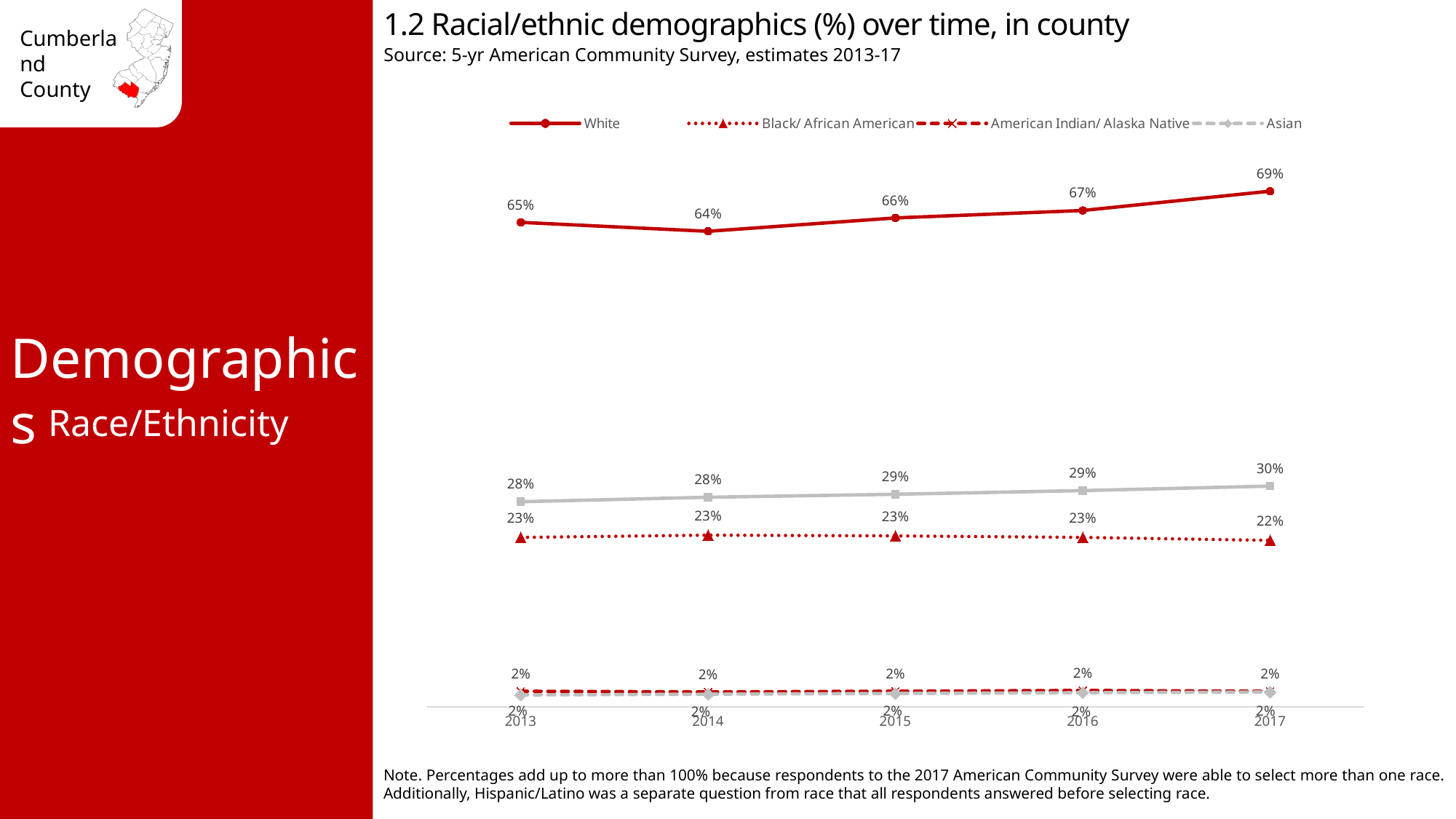
What is the value for White in 2017? 69% What is the value for Black/ African American in 2015? 23% In which year is the White percentage highest? 2017 What is the value for Black/ African American in 2017? 22% What kind of chart is shown on the slide? line chart Which is larger in 2013, the White value or the Black/ African American value? White Does the White percentage rise or fall from 2014 to 2017? rise What is the difference between the White value in 2017 and in 2013? 4 percentage points How many series does the legend list? 4 How many years are shown on the x axis? 5 In which year is the White percentage lowest? 2014 What is the value for White in 2014? 64%